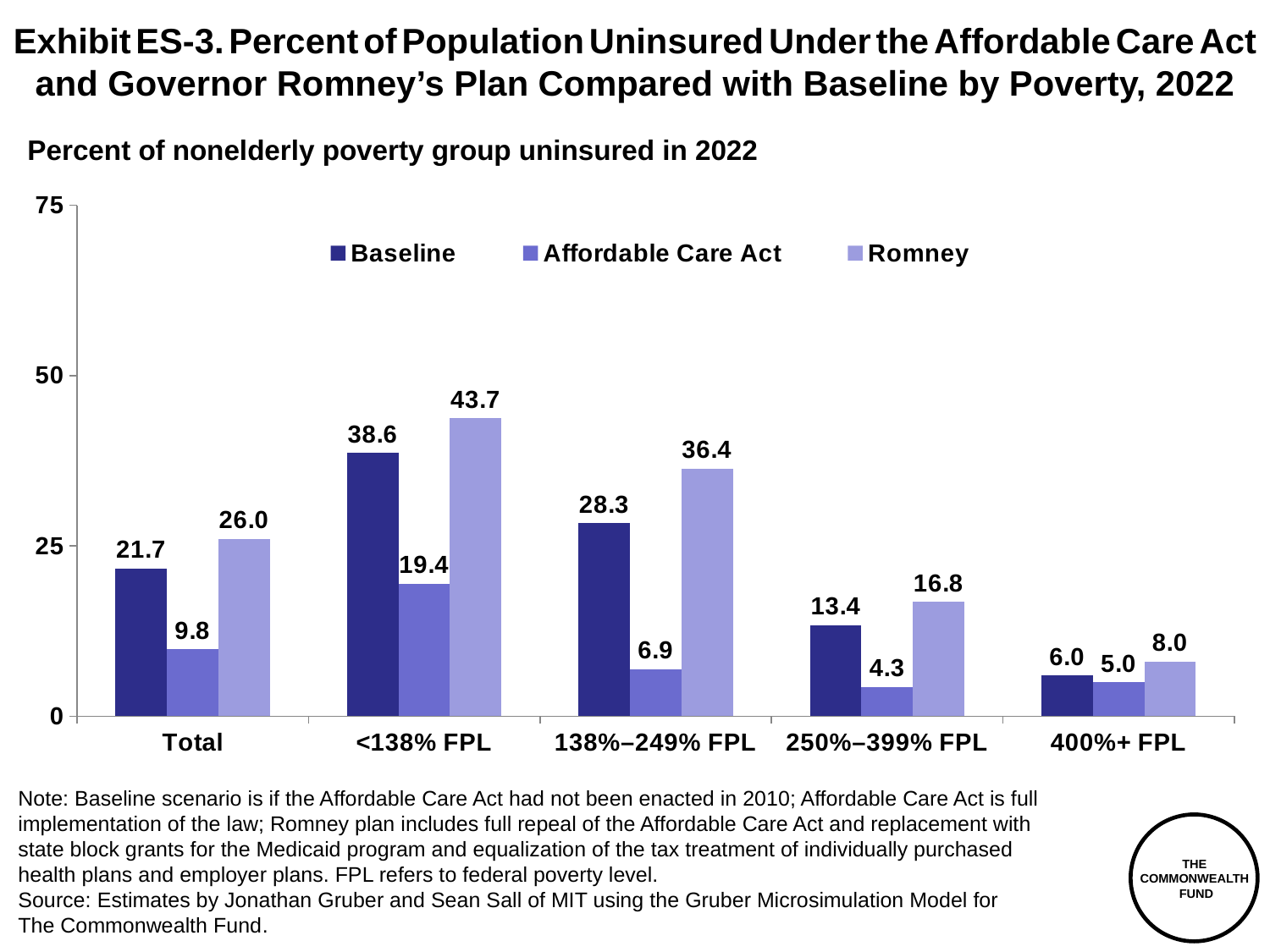
What is the Affordable Care Act value for the Total category? 9.8 What kind of chart is shown on the slide? bar chart Which poverty group has the highest Baseline value? <138% FPL Which is larger for the 400%+ FPL group, the Baseline value or the Romney value? Romney How many poverty group categories are shown on the x axis? 5 Which poverty group has the lowest Affordable Care Act value? 250%–399% FPL What is the maximum value shown on the y axis? 75 What is the difference between the Romney and Affordable Care Act values for the 138%–249% FPL group? 29.5 How many series does the legend list? 3 What is the Romney value for the <138% FPL group? 43.7 Is the Romney value for the Total category greater or less than 25? greater What is the Baseline value for the 250%–399% FPL group? 13.4